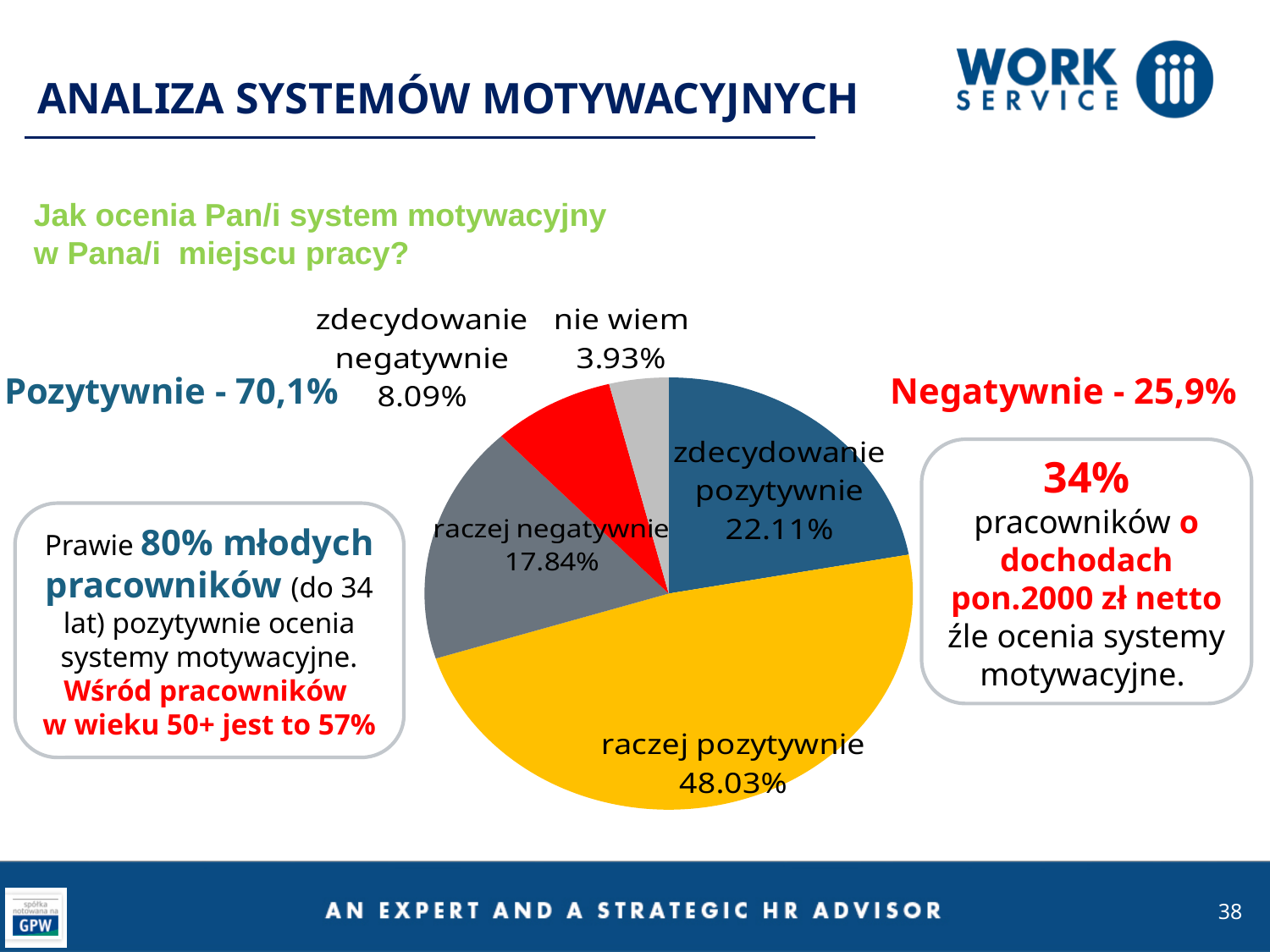
What percentage of respondents answered "raczej pozytywnie"? 48.03% What percentage of respondents answered "zdecydowanie pozytywnie"? 22.11% What type of chart is shown on the slide? pie chart What percentage of respondents answered "zdecydowanie negatywnie"? 8.09% What is the difference in percentage points between "raczej pozytywnie" and "zdecydowanie pozytywnie"? 25.92% What percentage of respondents answered "nie wiem"? 3.93% What percentage of respondents answered "raczej negatywnie"? 17.84% Which answer category has the smallest share of the pie? nie wiem Which answer category has the largest share of the pie? raczej pozytywnie How many slices does the pie chart have? 5 What colour is the "raczej pozytywnie" slice? yellow Which is larger: the share for "raczej negatywnie" or for "zdecydowanie negatywnie"? raczej negatywnie